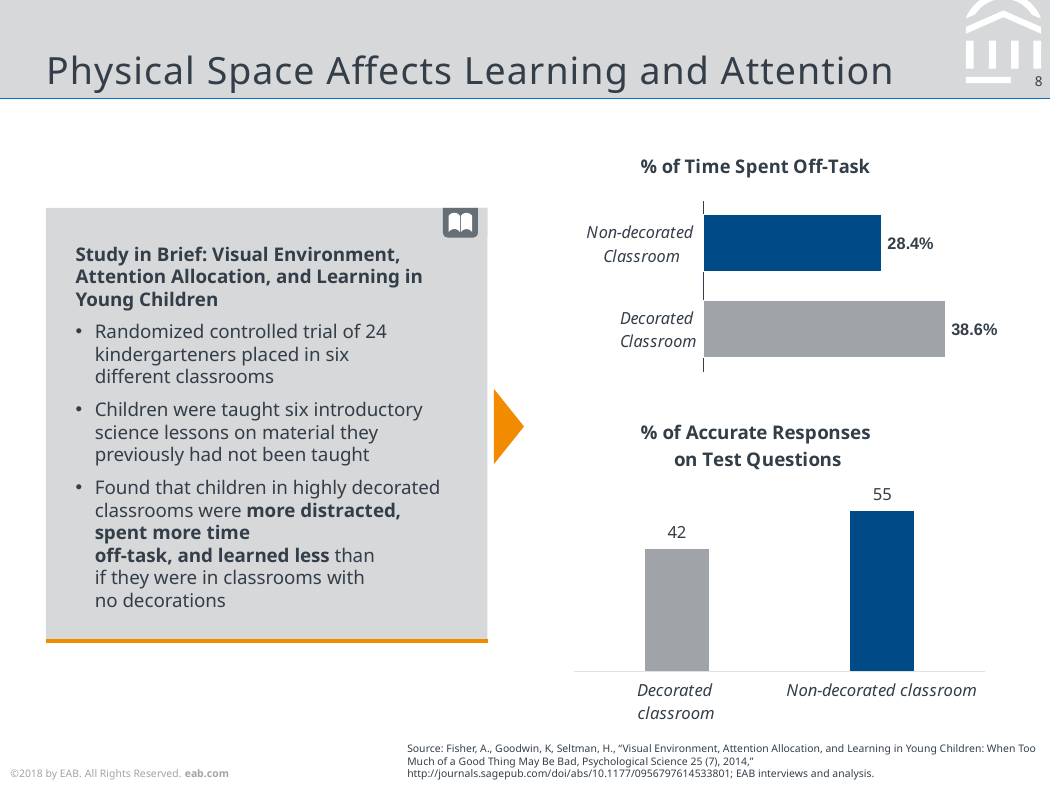
In the '% of Time Spent Off-Task' chart, what is the difference between the Decorated and Non-decorated Classroom values? 10.2% In the '% of Time Spent Off-Task' chart, what is the value for the Decorated Classroom? 38.6% In the '% of Time Spent Off-Task' chart, which classroom has the higher value? Decorated Classroom In the '% of Accurate Responses on Test Questions' chart, which classroom has the lower value? Decorated classroom In the '% of Accurate Responses on Test Questions' chart, what is the difference between the Non-decorated and Decorated classroom values? 13 What kind of chart is the '% of Accurate Responses on Test Questions' chart? Bar chart In the '% of Accurate Responses on Test Questions' chart, what is the value for the Decorated classroom? 42 How many categories are shown in the '% of Time Spent Off-Task' chart? 2 In the '% of Time Spent Off-Task' chart, what is the value for the Non-decorated Classroom? 28.4% What kind of chart is the '% of Time Spent Off-Task' chart? Bar chart In the '% of Accurate Responses on Test Questions' chart, what is the value for the Non-decorated classroom? 55 In the '% of Accurate Responses on Test Questions' chart, what colour is the bar for the Non-decorated classroom? Dark blue